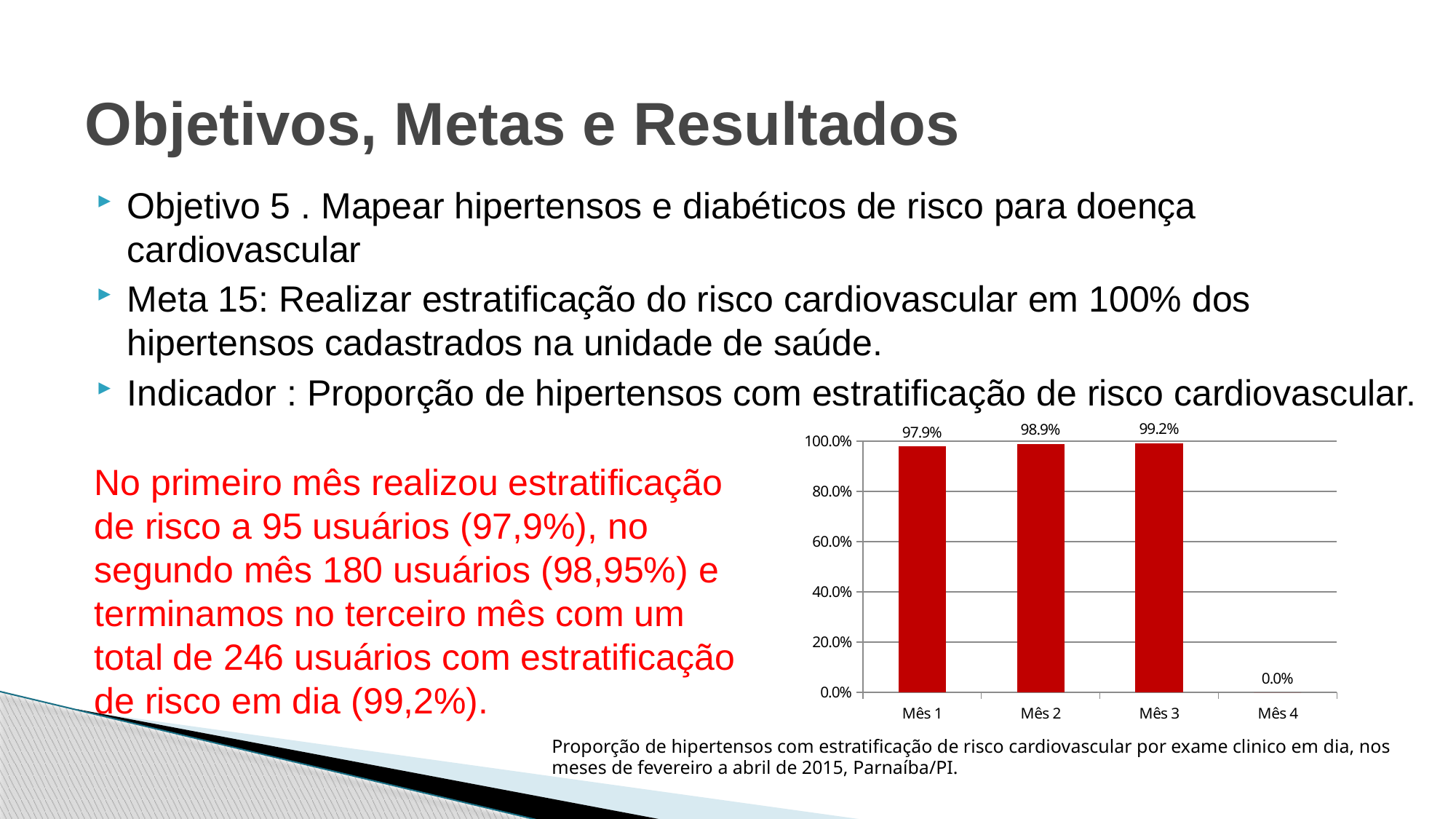
What is the value shown for Mês 4? 0.0% What is the value shown for Mês 2? 98.9% What kind of chart is shown on the slide? bar chart Do the values rise or fall from Mês 1 to Mês 3? rise Is the value for Mês 1 greater or less than 80.0%? greater Which month has the highest value in the chart? Mês 3 What is the value shown for Mês 3? 99.2% What is the value shown for Mês 1? 97.9% How many months are shown on the x axis of the chart? 4 What is the difference between the values for Mês 3 and Mês 1? 1.3 percentage points Which is larger, the value for Mês 1 or the value for Mês 2? Mês 2 Which month has the lowest value in the chart? Mês 4